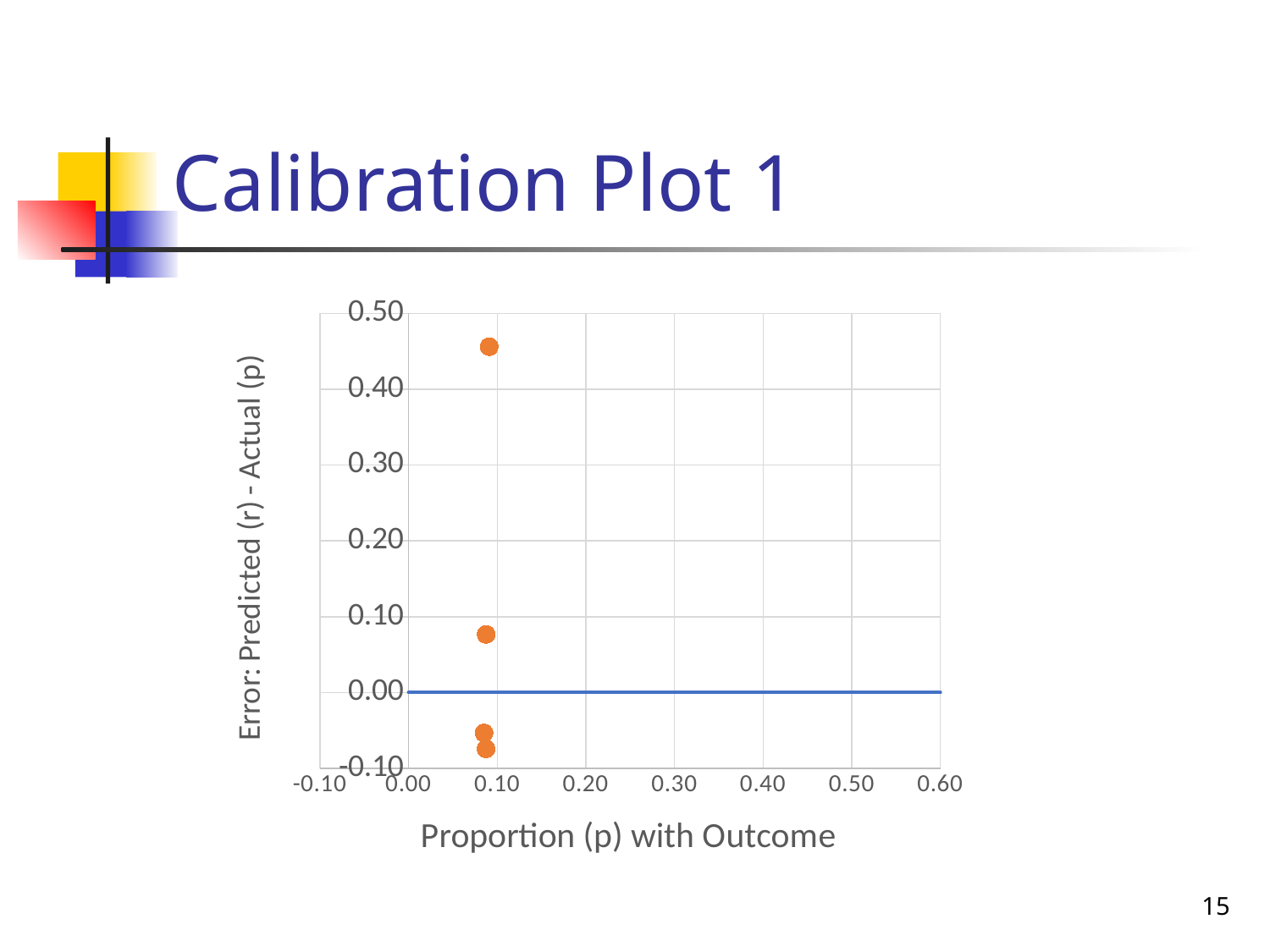
What is the label of the x axis? Proportion (p) with Outcome Is the error value of the second-highest orange point greater or less than 0.10? less Are there more orange points above the blue line or below it? equal (2 above, 2 below) What kind of chart is shown on the slide? scatter plot At what y value does the horizontal blue line sit? 0.00 What is the title of the chart on the slide? Calibration Plot 1 Is the error value of the lowest orange point greater or less than 0.00? less What is the highest value shown on the y axis? 0.50 How many orange data points are plotted on the chart? 4 Is the error value of the highest orange point greater or less than 0.50? less